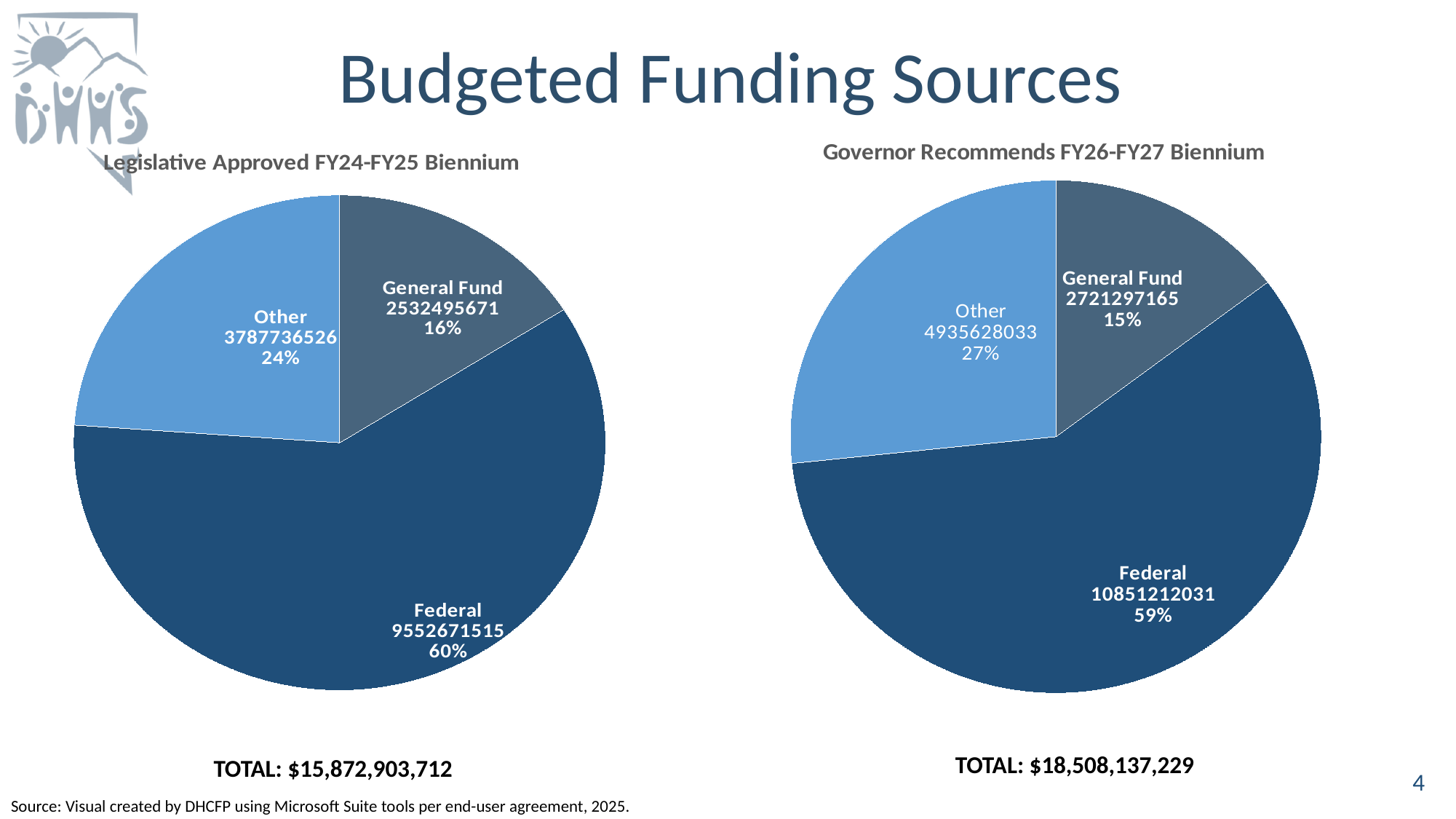
In the Governor Recommends FY26-FY27 Biennium chart, what share of the pie is Federal? 59% How many slices does the Legislative Approved FY24-FY25 Biennium chart have? 3 What type of chart is used for the Governor Recommends FY26-FY27 Biennium? Pie chart What is the difference between the Federal value in the Governor Recommends FY26-FY27 Biennium chart and the Federal value in the Legislative Approved FY24-FY25 Biennium chart? 1298540516 Which is larger: the General Fund share in the Legislative Approved FY24-FY25 Biennium chart or the General Fund share in the Governor Recommends FY26-FY27 Biennium chart? Legislative Approved FY24-FY25 Biennium In the Governor Recommends FY26-FY27 Biennium chart, what is the value for General Fund? 2721297165 In the Legislative Approved FY24-FY25 Biennium chart, which funding source is the largest? Federal In the Legislative Approved FY24-FY25 Biennium chart, what share of the pie is Other? 24% In the Legislative Approved FY24-FY25 Biennium chart, what is the value for Federal? 9552671515 In the Governor Recommends FY26-FY27 Biennium chart, what is the value for Other? 4935628033 In the Governor Recommends FY26-FY27 Biennium chart, which funding source is the smallest? General Fund What total is shown below the Governor Recommends FY26-FY27 Biennium chart? $18,508,137,229